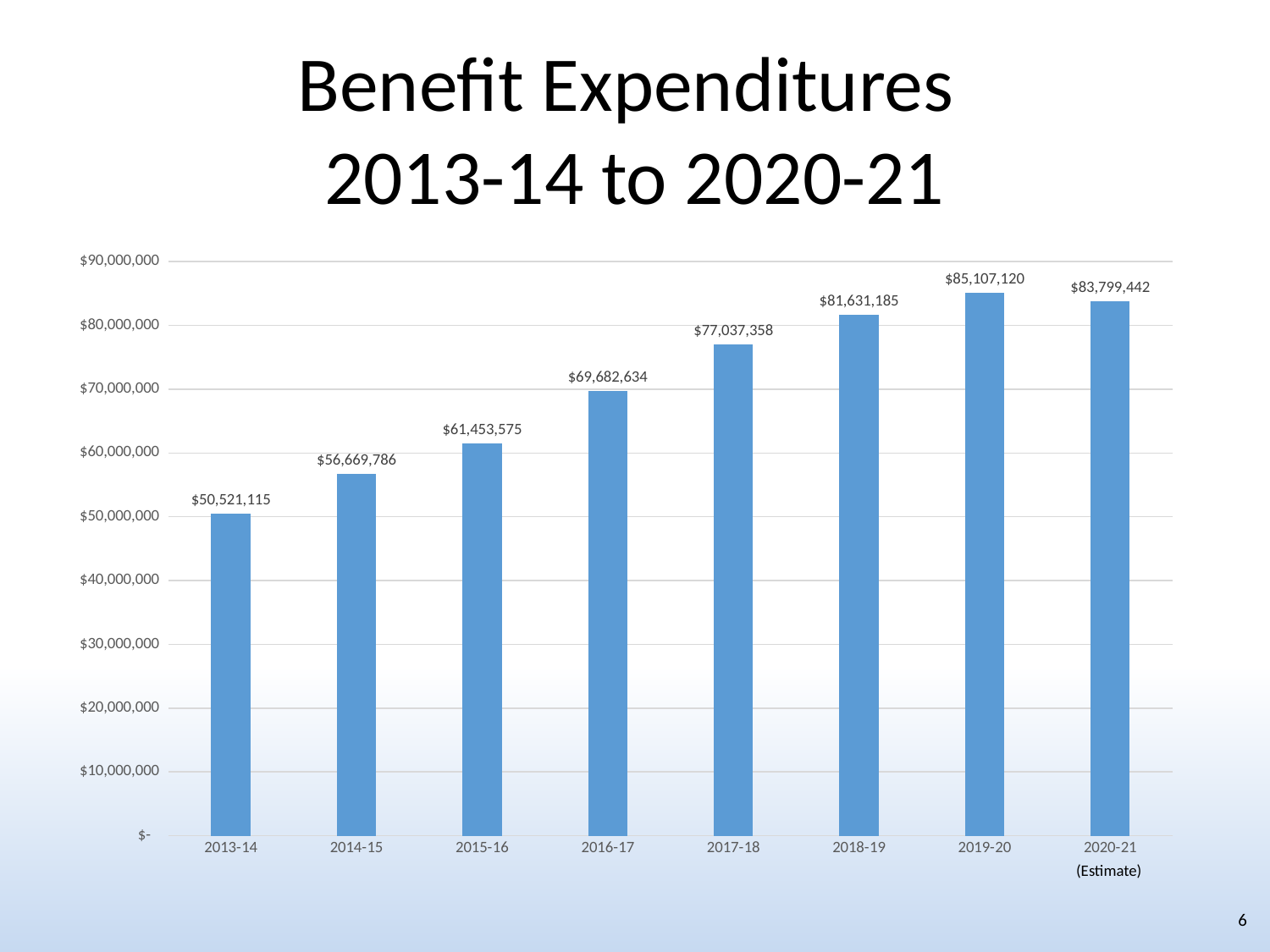
Which year has the lowest benefit expenditure? 2013-14 What kind of chart is this? bar chart What is the difference between the values for 2014-15 and 2013-14? $6,148,671 What is the title of the chart? Benefit Expenditures 2013-14 to 2020-21 What is the estimated value for 2020-21? $83,799,442 Which is larger, the value for 2018-19 or the value for 2020-21? 2020-21 Is the value for 2016-17 greater or less than $70,000,000? less What is the difference between the values for 2019-20 and 2020-21? $1,307,678 How many years are shown on the chart? 8 What is the value for 2013-14? $50,521,115 Which year has the highest benefit expenditure? 2019-20 What is the value for 2017-18? $77,037,358